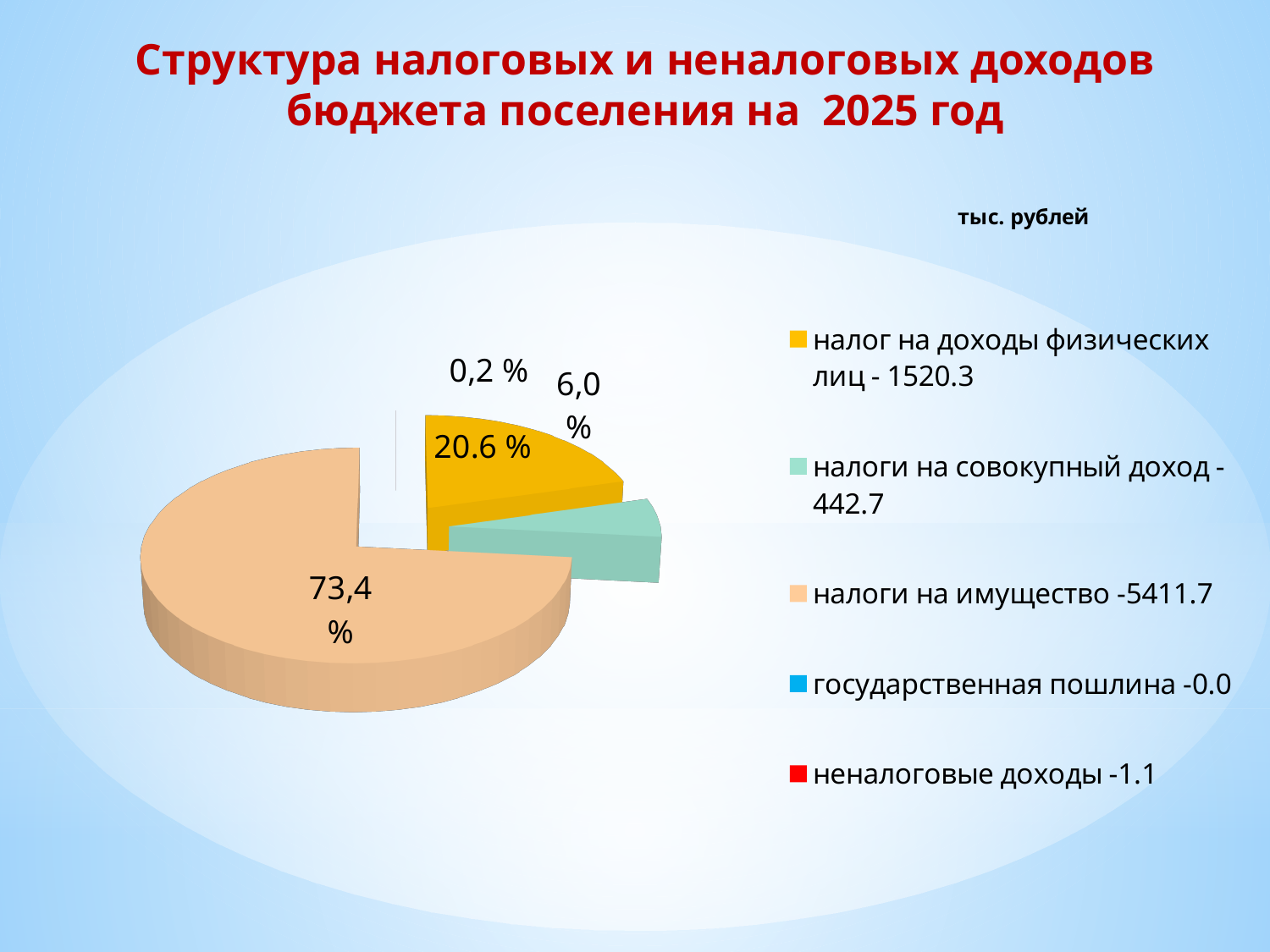
What is the value shown in the legend for налоги на имущество? 5411.7 What share of the pie does налог на доходы физических лиц take? 20.6 % What is the value shown in the legend for налог на доходы физических лиц? 1520.3 Which category has the largest value? налоги на имущество How many categories does the legend list? 5 What is the difference between налоги на имущество and налог на доходы физических лиц? 3891.4 What is the value shown in the legend for неналоговые доходы? 1.1 What is the value shown in the legend for налоги на совокупный доход? 442.7 Which is larger: налог на доходы физических лиц or налоги на совокупный доход? налог на доходы физических лиц What kind of chart is shown on the slide? pie chart Which category has the smallest value? государственная пошлина What share of the pie does налоги на имущество take? 73,4 %